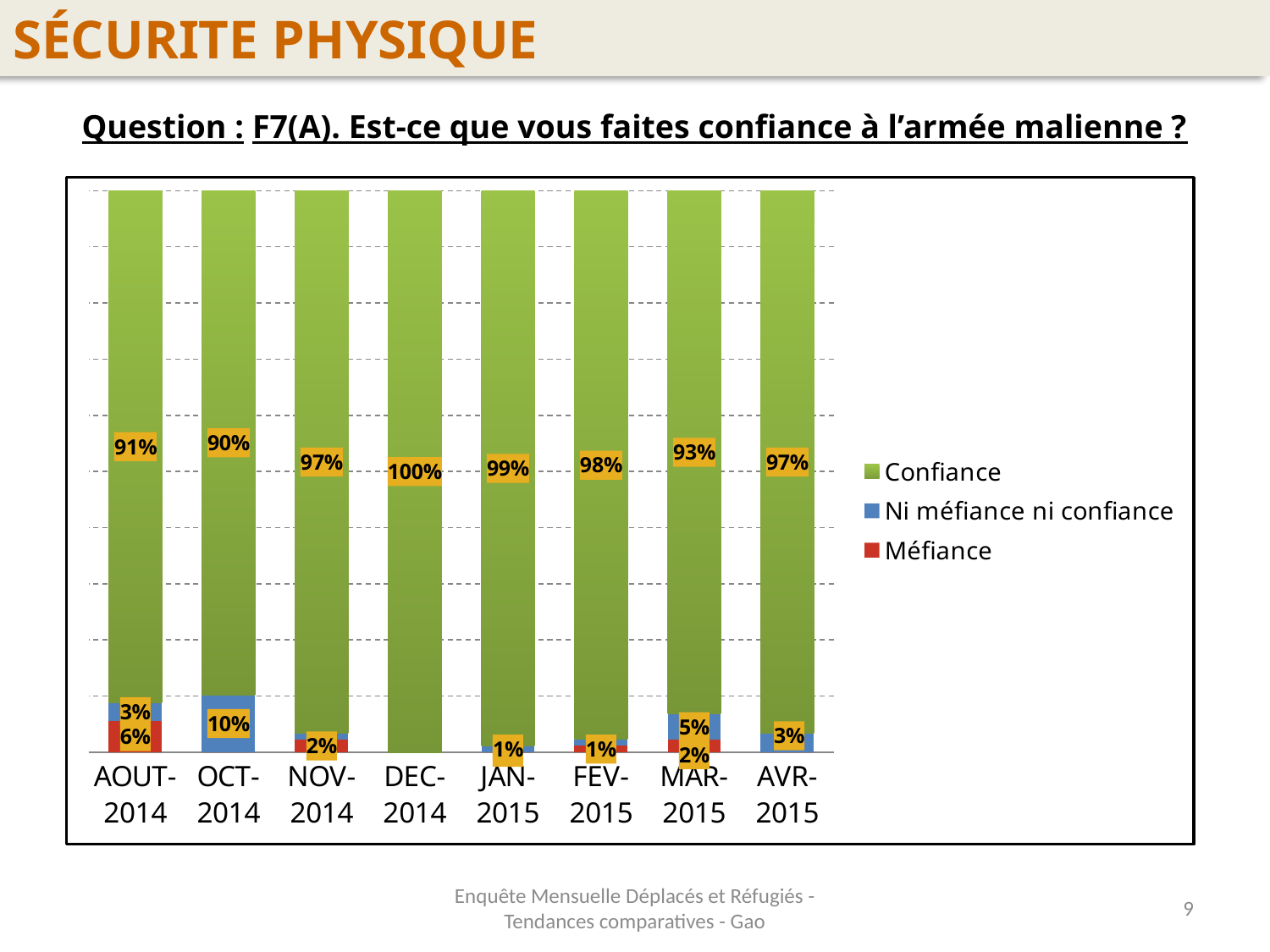
How many series does the legend list? 3 Which month has the lowest Confiance value? OCT-2014 What is the Ni méfiance ni confiance value for MAR-2015? 5% What is the difference between the Confiance values for NOV-2014 and AOUT-2014? 6% What is the Confiance value for DEC-2014? 100% What is the Ni méfiance ni confiance value for OCT-2014? 10% Which month has the highest Confiance value? DEC-2014 What type of chart is shown on the slide? stacked bar chart Which is larger, the Confiance value for JAN-2015 or for MAR-2015? JAN-2015 What is the Méfiance value for AOUT-2014? 6% How many months (categories) are shown on the x axis? 8 What is the Confiance value for OCT-2014? 90%